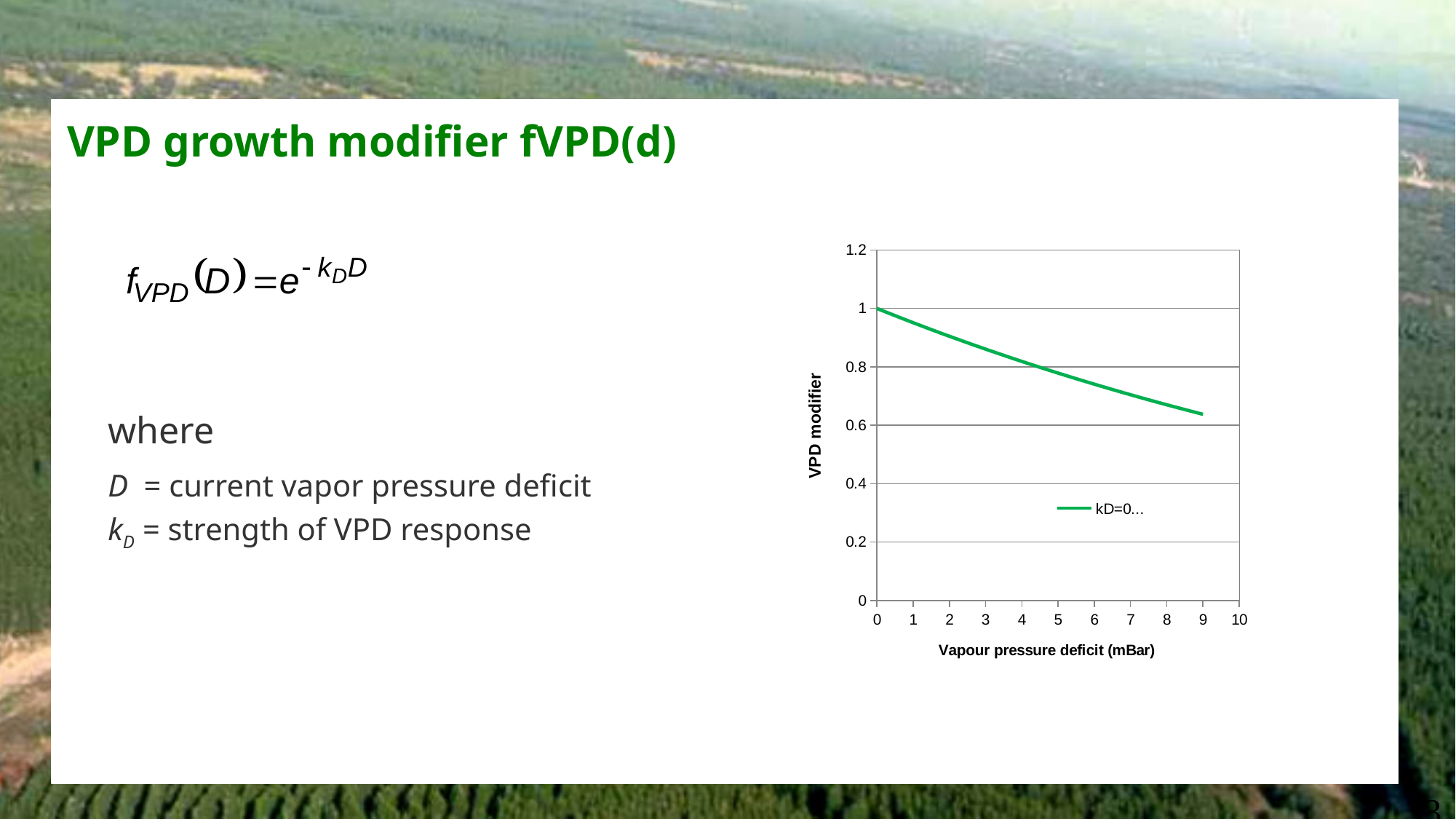
Is the VPD modifier at a vapour pressure deficit of 9 mBar greater or less than 0.8? less What is the title of the chart's y axis? VPD modifier What is the VPD modifier value at a vapour pressure deficit of 0 mBar? 1 Is the VPD modifier at a vapour pressure deficit of 2 mBar greater or less than 0.8? greater How many series does the chart's legend list? 1 What is the title of the chart's x axis? Vapour pressure deficit (mBar) Which has the larger VPD modifier: a vapour pressure deficit of 1 mBar or 8 mBar? 1 mBar Does the VPD modifier rise or fall as the vapour pressure deficit increases along the x axis? fall Is the VPD modifier at a vapour pressure deficit of 9 mBar greater or less than 0.6? greater At which vapour pressure deficit value is the VPD modifier highest? 0 At which plotted vapour pressure deficit value is the VPD modifier lowest? 9 What kind of chart is shown on the slide? line chart